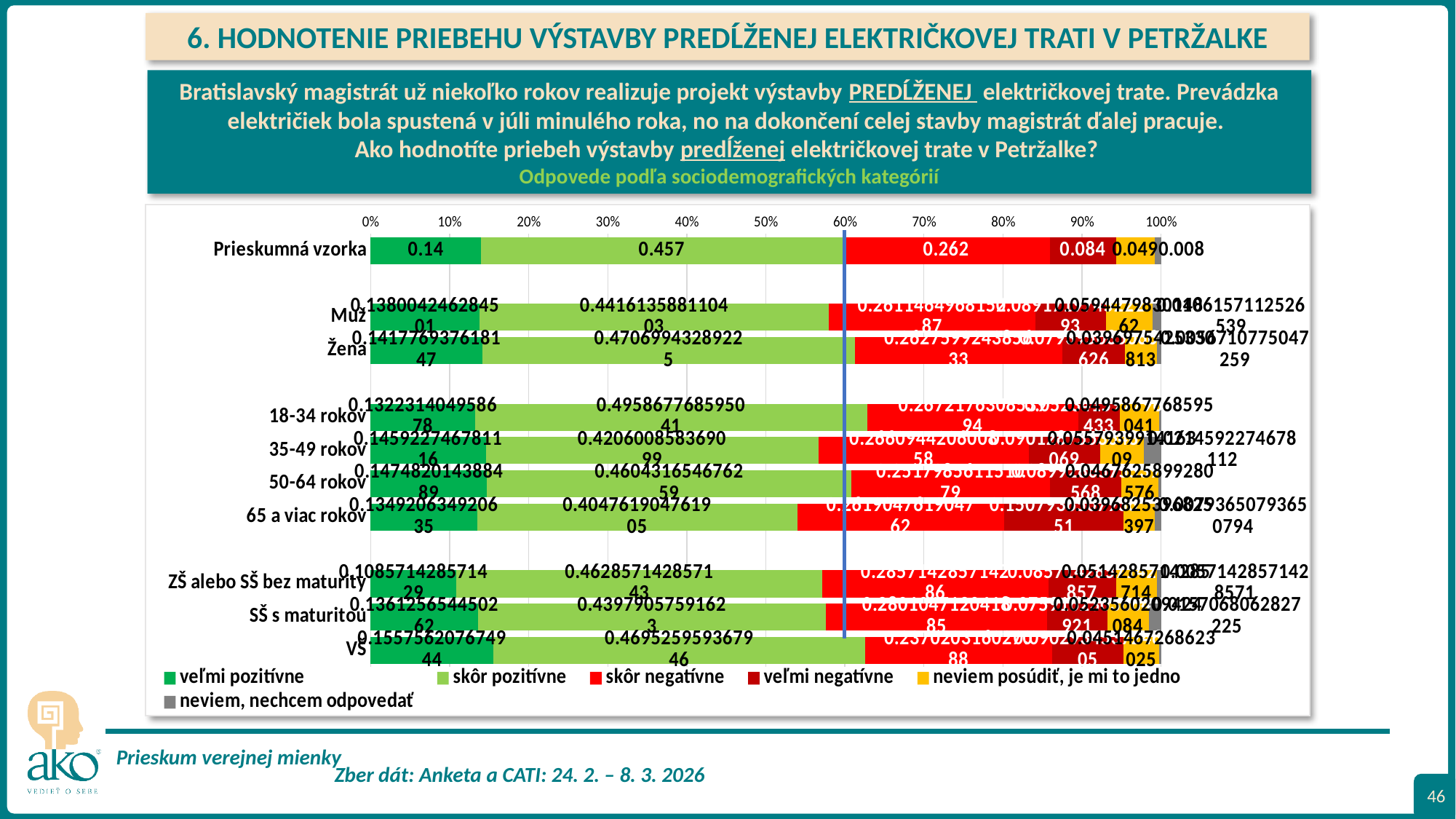
What is the value for "skôr pozitívne" in the "Prieskumná vzorka" bar? 0.457 Which response category has the largest share in the "Prieskumná vzorka" bar? skôr pozitívne How many series does the legend list? 6 How many category bars are plotted in the chart? 10 In the "Prieskumná vzorka" bar, what is the difference between "skôr pozitívne" and "skôr negatívne"? 0.195 In the "Prieskumná vzorka" bar, which is larger: "veľmi pozitívne" or "veľmi negatívne"? veľmi pozitívne What is the value for "skôr negatívne" in the "Prieskumná vzorka" bar? 0.262 In the "Prieskumná vzorka" bar, what is the combined share of "veľmi pozitívne" and "skôr pozitívne"? 0.597 What kind of chart is shown on the slide? stacked bar chart Which response category has the smallest share in the "Prieskumná vzorka" bar? neviem, nechcem odpovedať What is the value for "veľmi pozitívne" in the "Prieskumná vzorka" bar? 0.14 What is the value for "veľmi negatívne" in the "Prieskumná vzorka" bar? 0.084